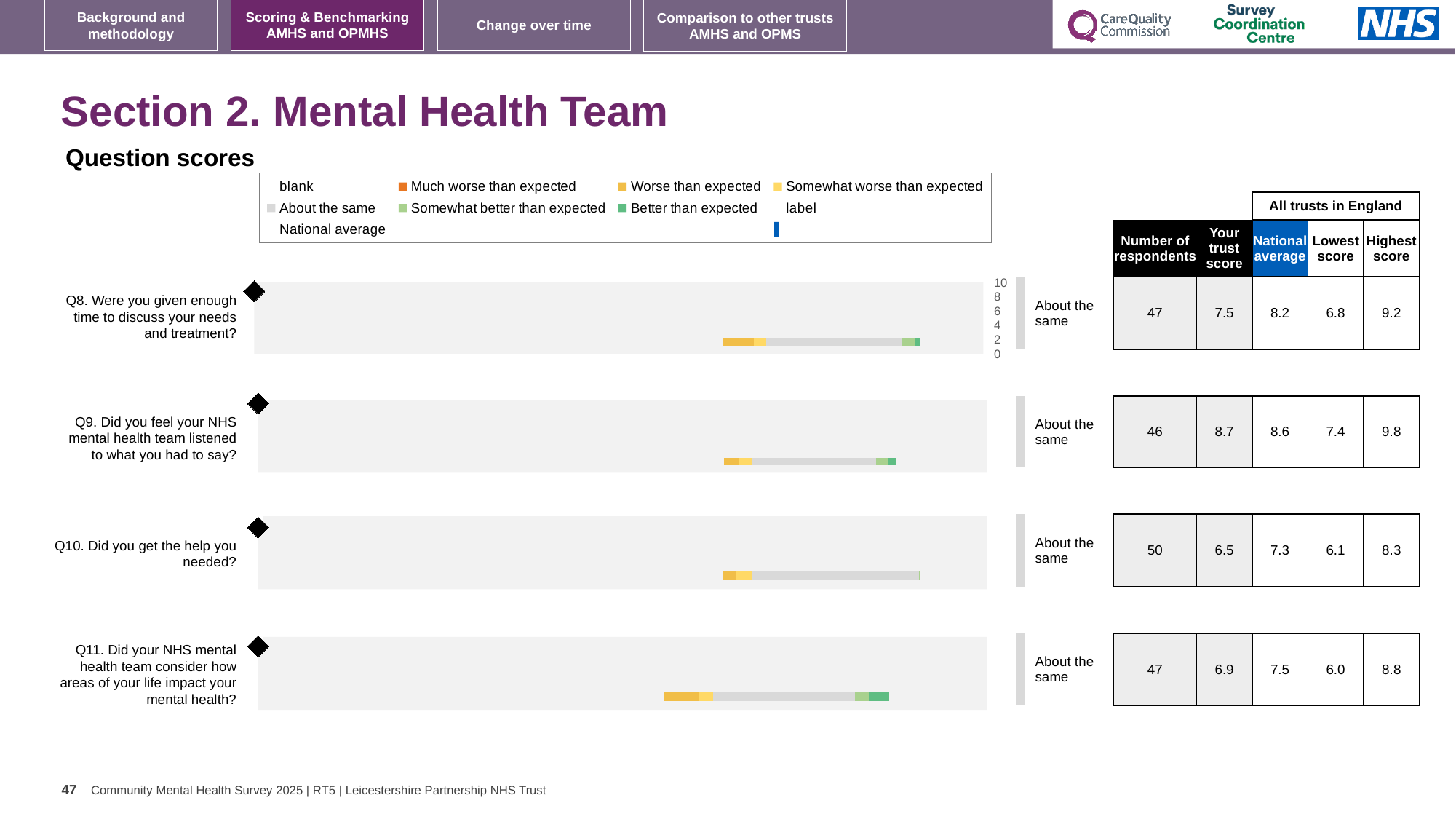
For Q8, what is the difference between the National average (8.2) and Your trust score (7.5)? 0.7 For Q11 (Did your NHS mental health team consider how areas of your life impact your mental health?), what is the Lowest score among all trusts in England? 6.0 For Q11, which is larger: Your trust score or the National average? National average Which question has the highest 'Your trust score' on this slide? Q9 For Q10 (Did you get the help you needed?), how many respondents are listed? 50 Is the 'Your trust score' for Q9 greater or less than 8? greater How many questions (Q8 to Q11) have a score chart on this slide? 4 What benchmark category is shown next to the Q10 chart? About the same For Q9 (Did you feel your NHS mental health team listened to what you had to say?), what is the National average score? 8.6 What kind of chart is used to show the question scores for Q8 to Q11? bar chart For Q8 (Were you given enough time to discuss your needs and treatment?), what is the 'Your trust score' value? 7.5 Which question has the lowest 'Your trust score' on this slide? Q10